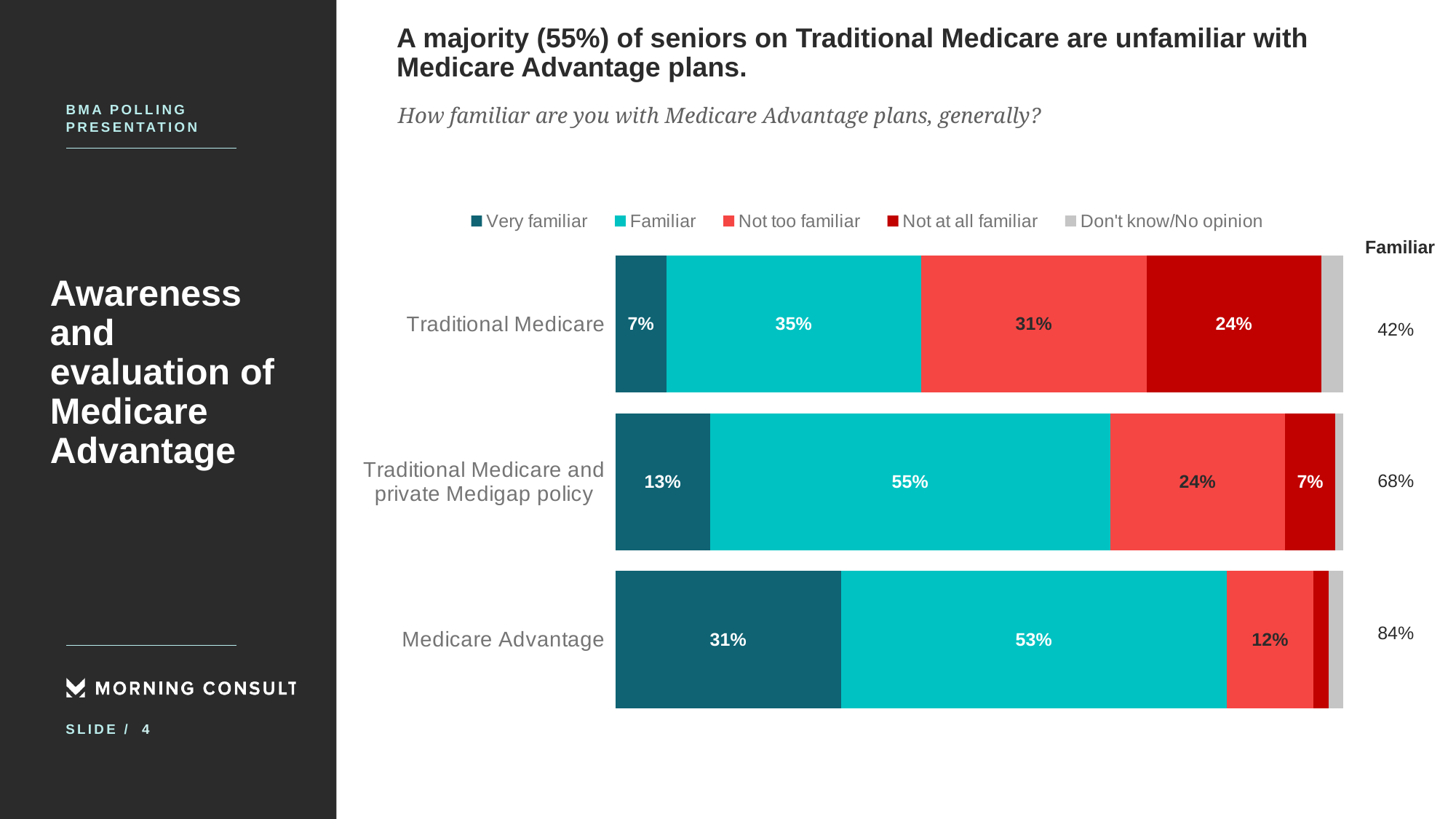
Which category has the highest "Very familiar" value? Medicare Advantage What is the difference between the "Familiar" values for Medicare Advantage and Traditional Medicare? 18 percentage points What kind of chart is shown on the slide? Stacked bar chart What percentage of Traditional Medicare respondents are "Very familiar" with Medicare Advantage plans? 7% What is the "Not too familiar" value for Medicare Advantage? 12% Which is larger: the "Not too familiar" value for Traditional Medicare or for Traditional Medicare and private Medigap policy? Traditional Medicare What is the "Not at all familiar" value for Traditional Medicare? 24% What is the combined "Familiar" total shown for Medicare Advantage at the right of the chart? 84% How many series does the legend list? 5 Which category has the lowest combined "Familiar" total shown at the right of the chart? Traditional Medicare What is the "Familiar" value for the Traditional Medicare and private Medigap policy category? 55% How many categories are plotted on the chart? 3